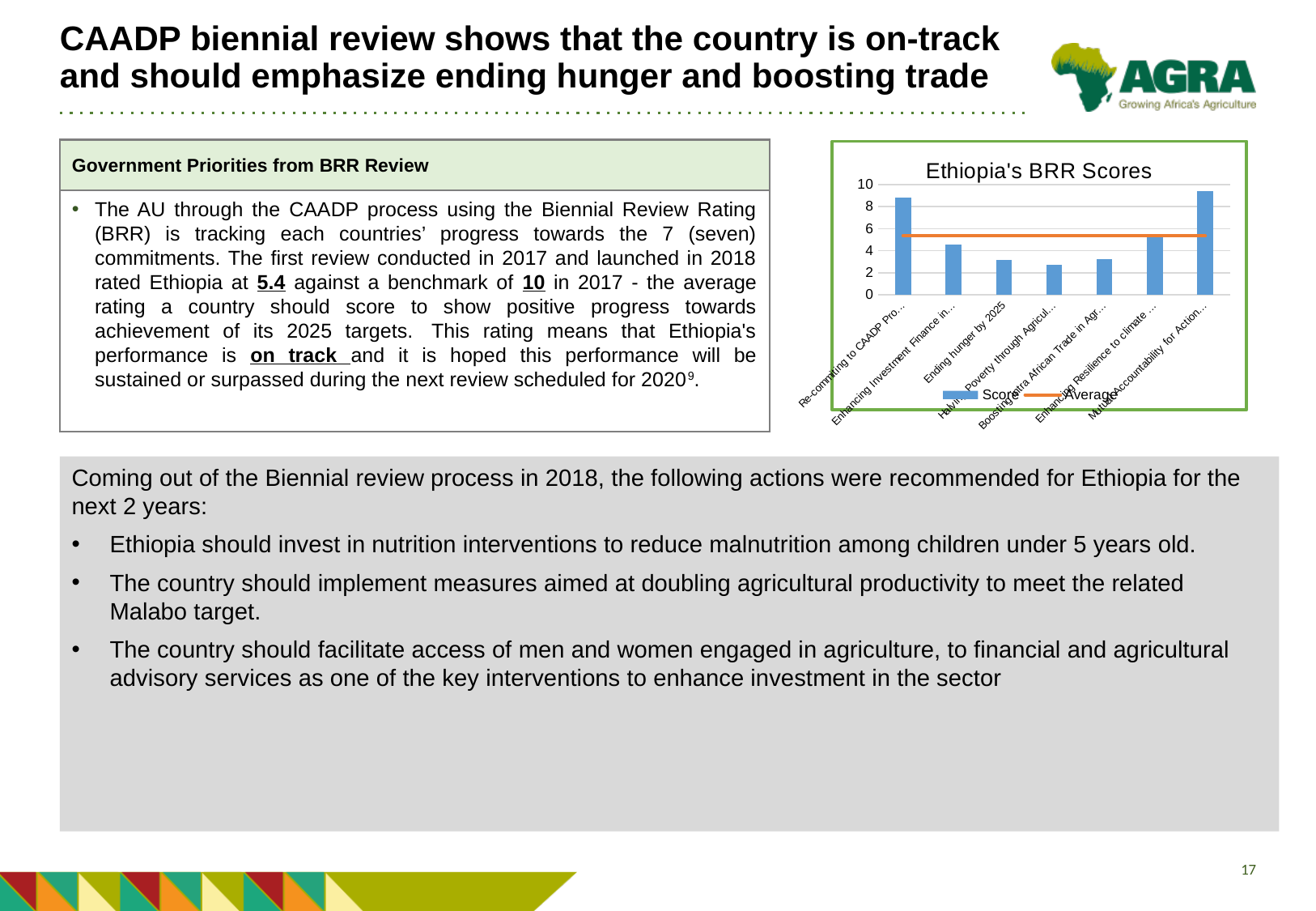
What kind of chart is "Ethiopia's BRR Scores"? combination bar and line chart In the "Ethiopia's BRR Scores" chart, which has the higher score: "Enhancing Resilience to climate ..." or "Boosting Intra African Trade in Agr..."? Enhancing Resilience to climate ... In the "Ethiopia's BRR Scores" chart, is the score for "Mutual Accountability for Action..." greater or less than 8? greater In the "Ethiopia's BRR Scores" chart, is the score for "Enhancing Resilience to climate ..." greater or less than 6? less How many categories (bars) are plotted in the "Ethiopia's BRR Scores" chart? 7 What are the two legend entries in the "Ethiopia's BRR Scores" chart? Score and Average In the "Ethiopia's BRR Scores" chart, is the score for "Re-committing to CAADP Pro..." greater or less than 8? greater How many series does the legend of the "Ethiopia's BRR Scores" chart list? 2 In the "Ethiopia's BRR Scores" chart, which has the higher score: "Re-committing to CAADP Pro..." or "Ending hunger by 2025"? Re-committing to CAADP Pro... What is the title of the chart on the slide? Ethiopia's BRR Scores